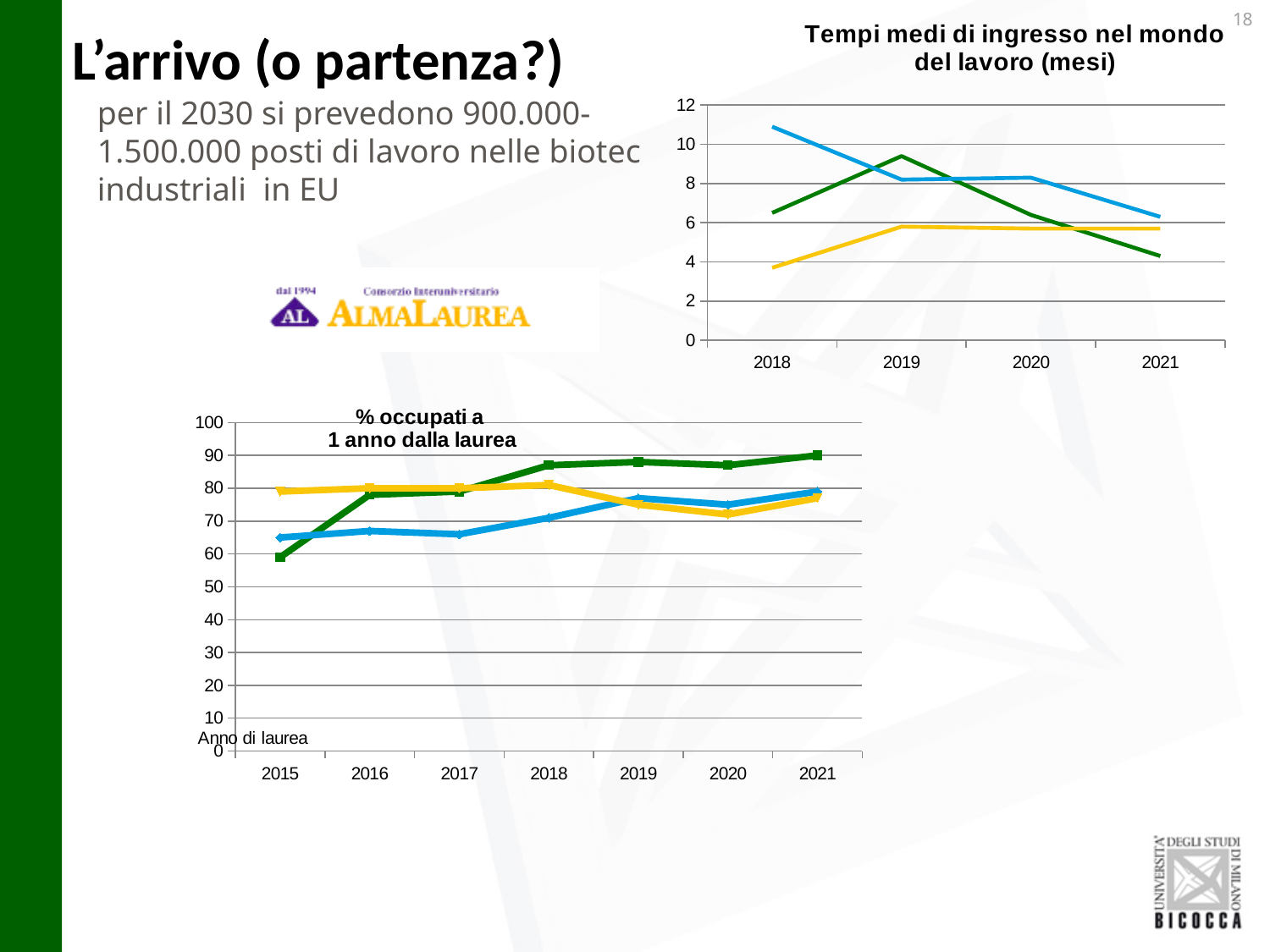
In the chart titled '% occupati a 1 anno dalla laurea', is the value of the blue line in 2015 greater or less than 70? less In the chart titled 'Tempi medi di ingresso nel mondo del lavoro (mesi)', is the value of the blue line in 2018 greater or less than 10? greater In the chart titled 'Tempi medi di ingresso nel mondo del lavoro (mesi)', which line has the higher value in 2021, the blue line or the green line? the blue line What kind of chart is the chart titled 'Tempi medi di ingresso nel mondo del lavoro (mesi)'? line chart In the chart titled '% occupati a 1 anno dalla laurea', does the green line rise or fall from 2015 to 2021? rise In the chart titled '% occupati a 1 anno dalla laurea', how many years are shown on the x axis? 7 In the chart titled '% occupati a 1 anno dalla laurea', which line has the highest value in 2021? the green line In the chart titled 'Tempi medi di ingresso nel mondo del lavoro (mesi)', in which year does the green line reach its highest value? 2019 In the chart titled 'Tempi medi di ingresso nel mondo del lavoro (mesi)', how many years are shown on the x axis? 4 In the chart titled 'Tempi medi di ingresso nel mondo del lavoro (mesi)', is the value of the yellow line in 2018 greater or less than 4? less In the chart titled 'Tempi medi di ingresso nel mondo del lavoro (mesi)', does the blue line rise or fall from 2018 to 2021? fall